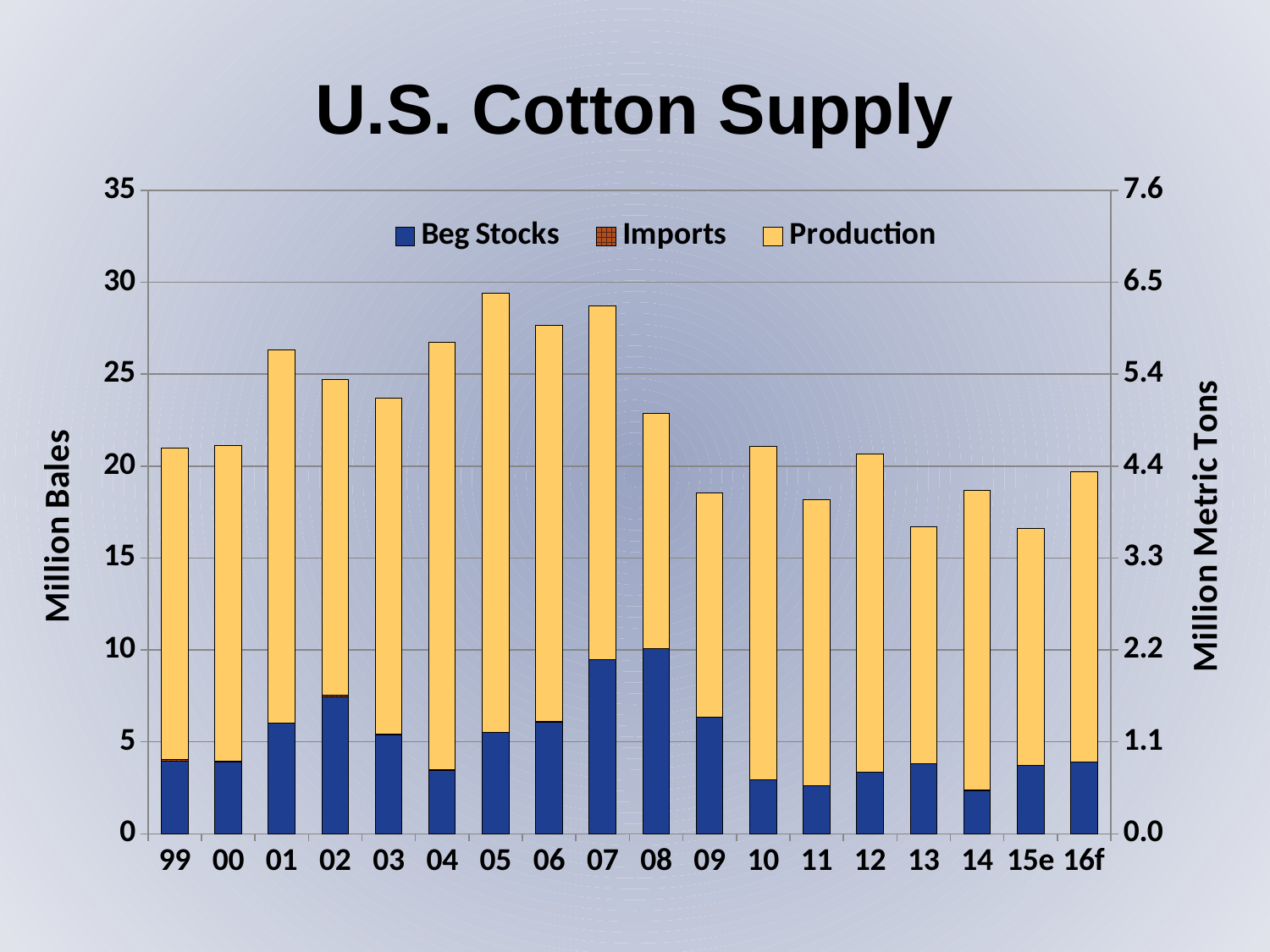
Is the total supply for 05 greater or less than 25 million bales? greater Which year has the highest Beg Stocks value? 08 Do the total supply bars rise or fall from 05 to 09? fall Which year has the larger Beg Stocks value, 02 or 03? 02 How many series does the legend list? 3 Is the Beg Stocks value for 07 greater or less than 5 million bales? greater What is the title of the left vertical axis? Million Bales Is the total supply for 13 greater or less than 20 million bales? less Which year has the highest total U.S. cotton supply? 05 What kind of chart is shown on the slide? Stacked bar chart Which year has the larger total supply, 01 or 02? 01 How many years (categories) are shown on the x axis? 18